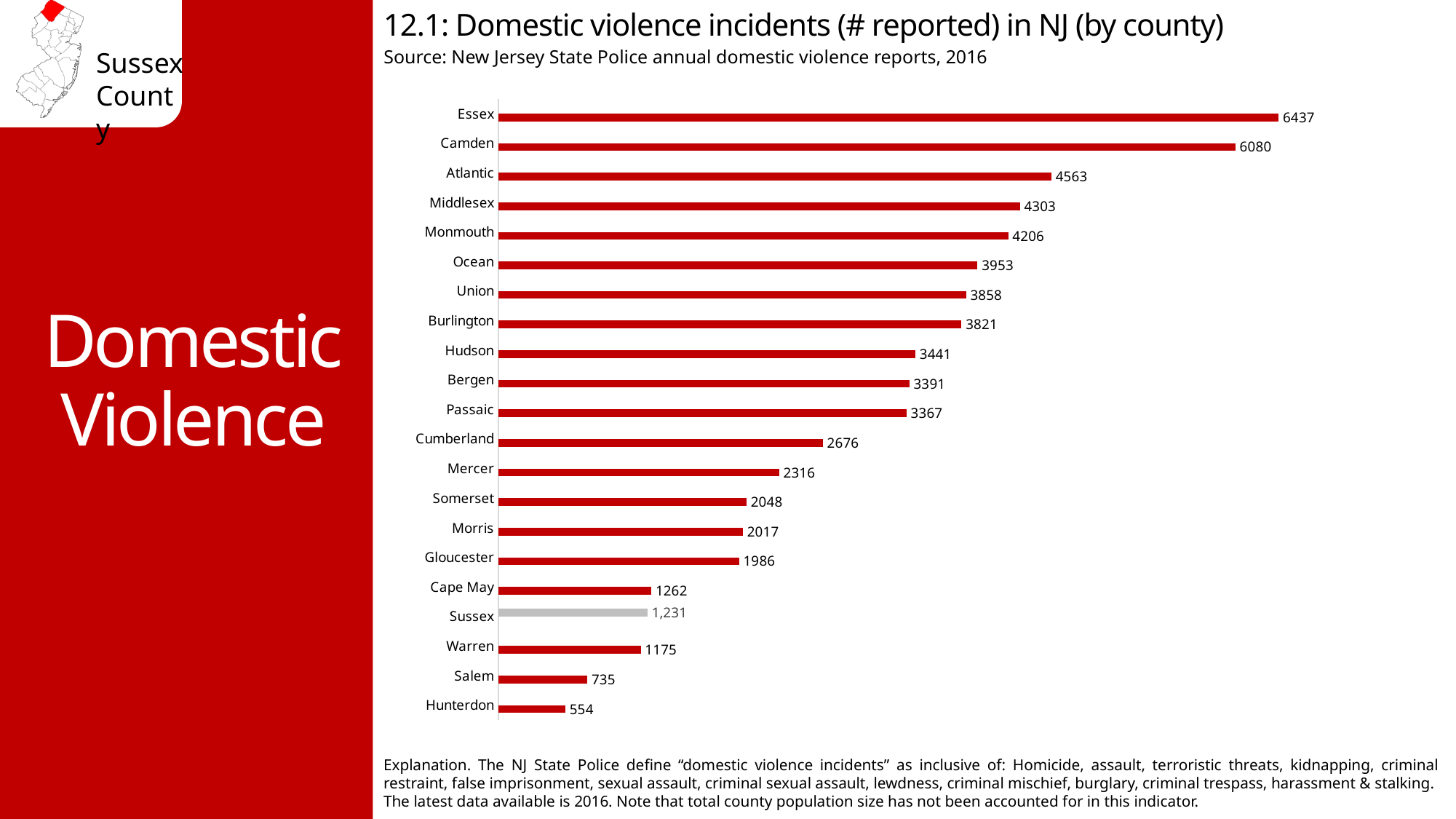
Which county has the highest number of reported domestic violence incidents? Essex What is the value shown for Sussex County? 1,231 Which county has more reported incidents, Atlantic or Middlesex? Atlantic Which county's bar is shown in grey rather than red? Sussex How many domestic violence incidents were reported in Essex County? 6437 Which county has more reported incidents, Salem or Warren? Warren What is the difference between the values for Essex and Camden? 357 How many counties are shown in the chart? 21 Which county has the lowest number of reported domestic violence incidents? Hunterdon What kind of chart is shown on the slide? Bar chart What is the difference between the values for Cape May and Warren? 87 How many incidents were reported in Hunterdon County? 554